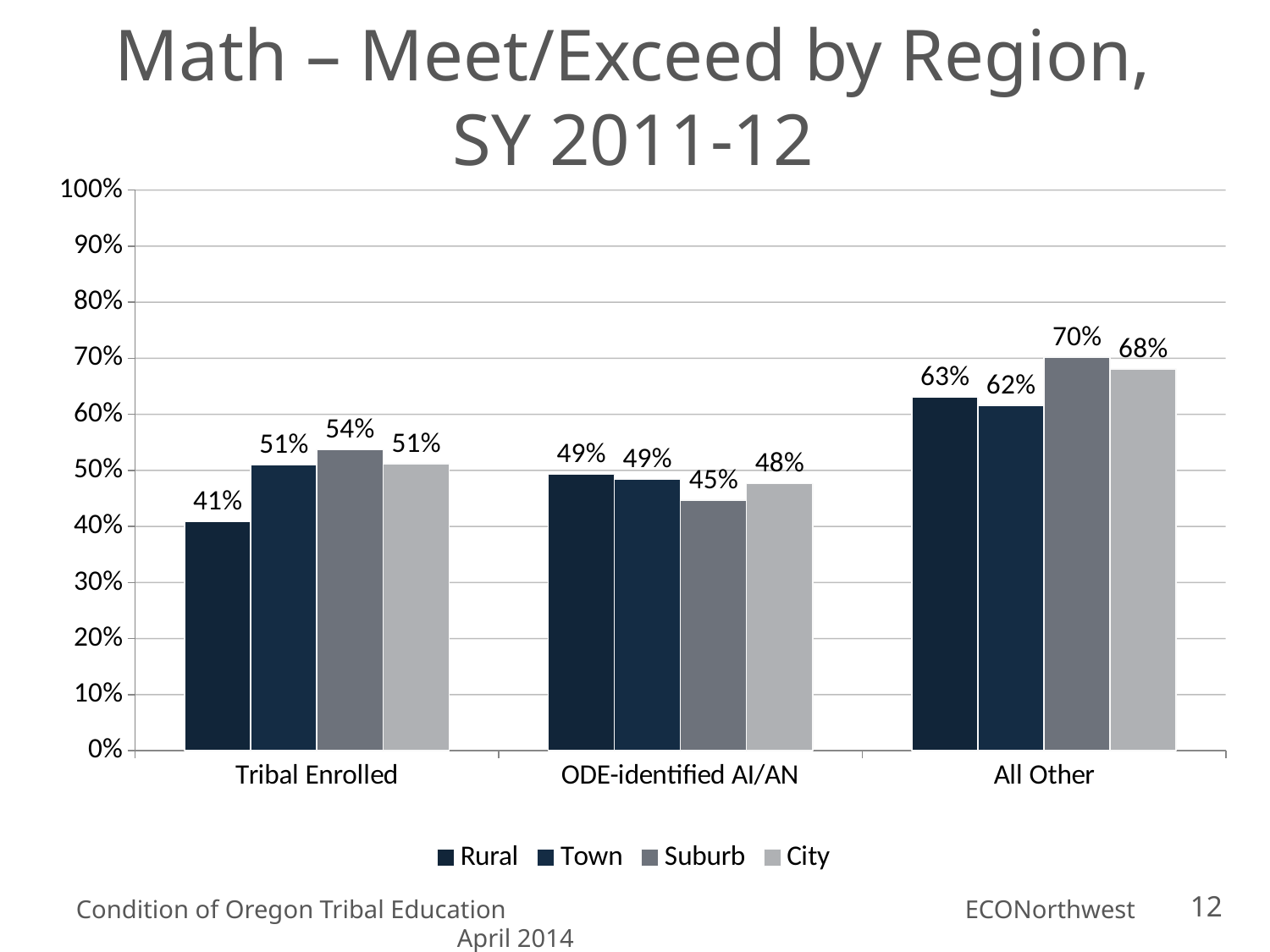
What is the City value for ODE-identified AI/AN? 48% What is the difference between the Suburb and Rural values for Tribal Enrolled? 13% What kind of chart is shown on the slide? Bar chart What is the title of the chart? Math – Meet/Exceed by Region, SY 2011-12 Which series has the highest value in the Tribal Enrolled group? Suburb What is the Suburb value for All Other? 70% Which is larger for All Other: the Suburb value or the Rural value? Suburb What is the Rural value for Tribal Enrolled? 41% Is the Town value for All Other greater or less than 50%? greater Which series has the lowest value in the ODE-identified AI/AN group? Suburb How many categories are shown on the x axis? 3 How many series does the legend list? 4